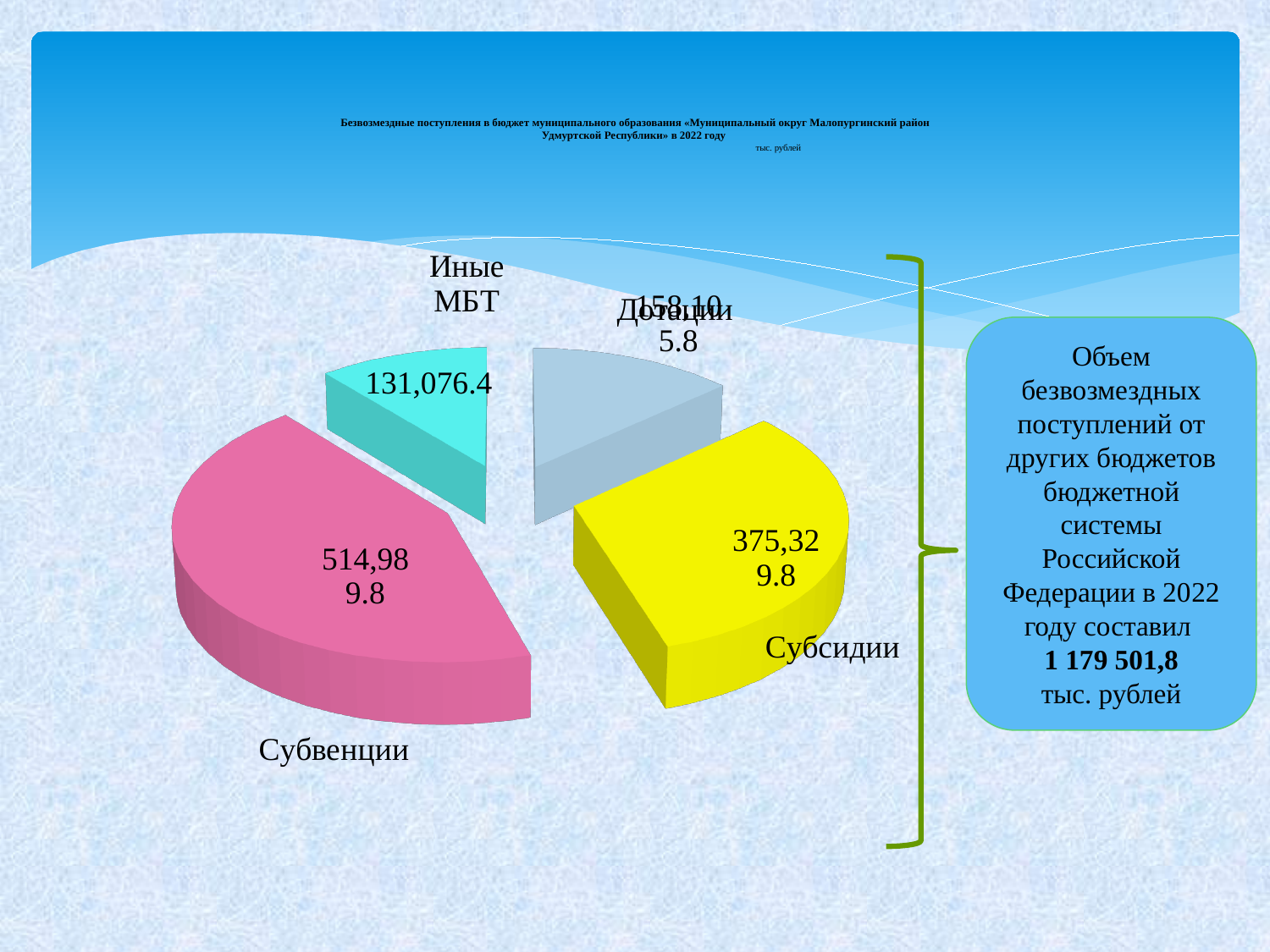
Which is larger, Субсидии or Иные МБТ? Субсидии What is the value shown for Иные МБТ? 131,076.4 What is the difference between the values for Субвенции and Субсидии? 139,660.0 In what units are the chart values given, according to the chart title? тыс. рублей What colour is the Субвенции slice? pink What is the difference between the values for Субсидии and Иные МБТ? 244,253.4 What is the value shown for Субсидии? 375,329.8 Which category has the largest slice of the pie? Субвенции How many slices does the pie chart have? 4 What kind of chart is shown on the slide? pie chart Which is larger, Субвенции or Субсидии? Субвенции What is the value shown for Субвенции? 514,989.8